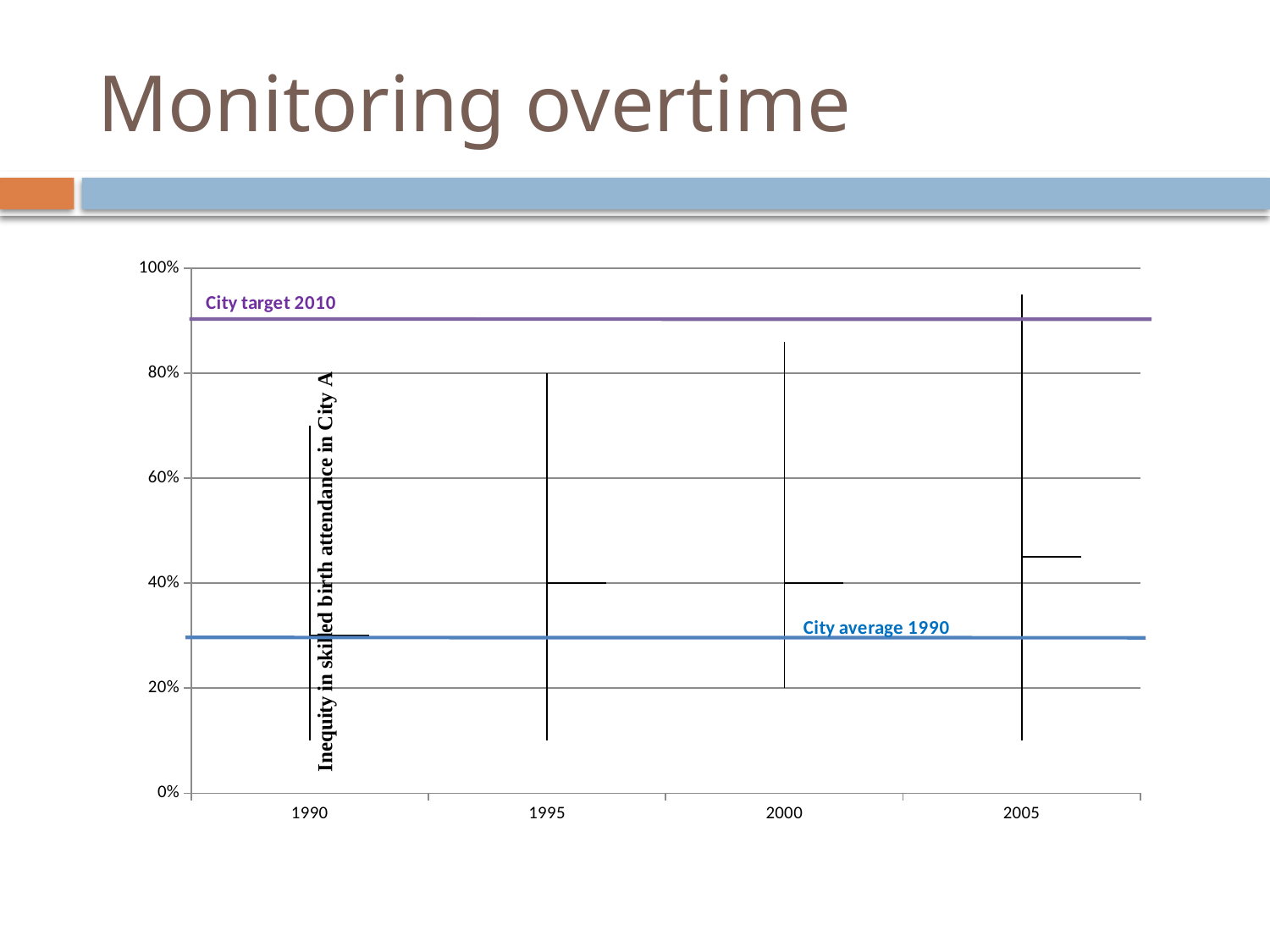
Is the City average 1990 line greater or less than 40%? less Which year has the vertical line with the lowest top end? 1990 Which is larger, the horizontal marker for 2005 or the horizontal marker for 1990? 2005 What are the two labelled horizontal reference lines on the chart called? City target 2010 and City average 1990 Is the horizontal marker for 1990 greater or less than 40%? less Is the horizontal marker for 2005 greater or less than 40%? greater How many years are marked on the x axis of the chart? 4 Which year has the vertical line reaching the highest value? 2005 What is the label on the vertical axis of the chart? Inequity in skilled birth attendance in City A Do the horizontal markers rise or fall from 1990 to 2005? rise